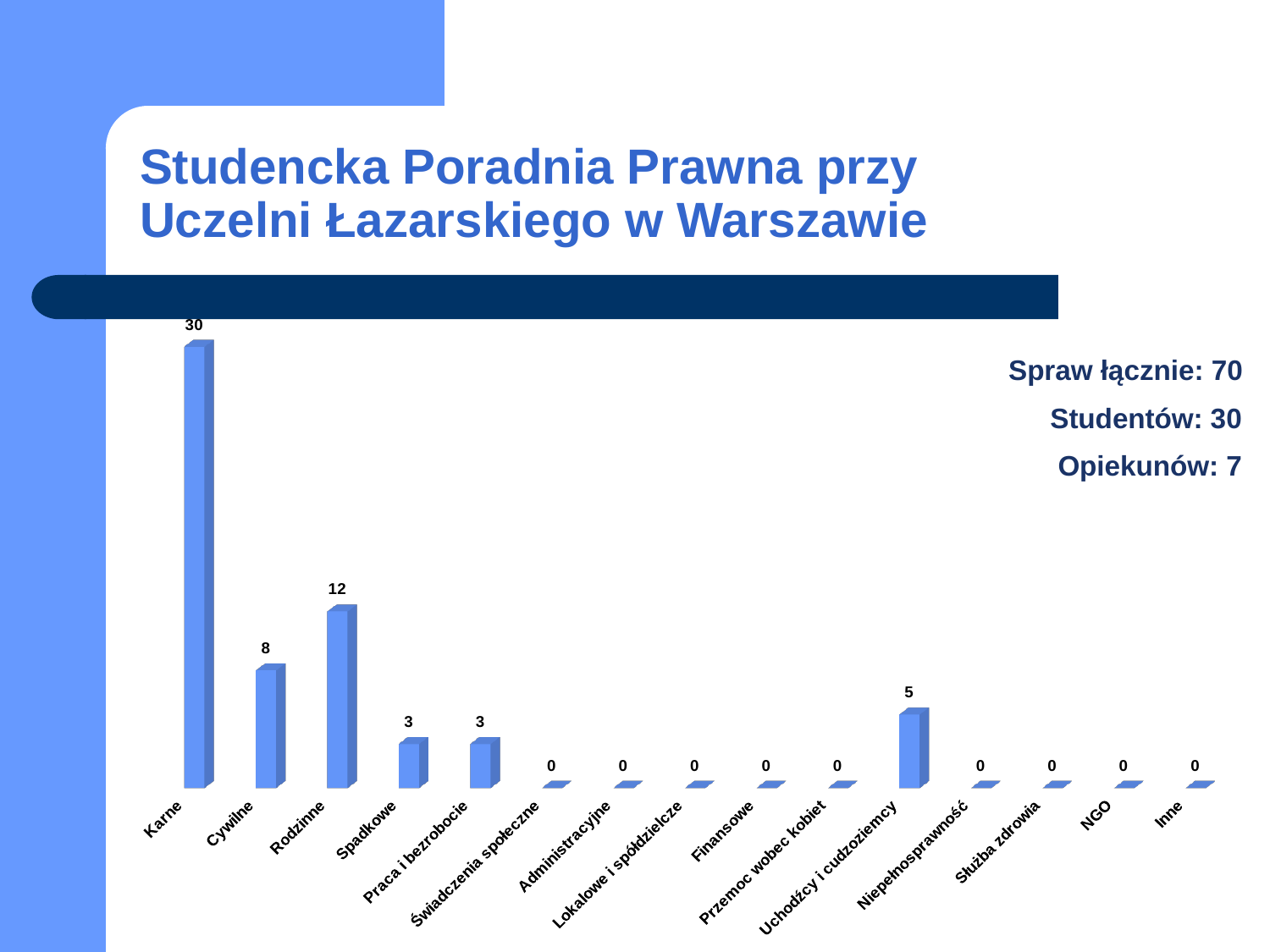
How many categories have a value of 0? 9 Which is larger, the value for Cywilne or the value for Rodzinne? Rodzinne What is the value for Rodzinne? 12 What kind of chart is shown on the slide? Bar chart How many categories are shown on the x axis? 15 What is the value for Karne? 30 What is the difference between the values for Cywilne and Spadkowe? 5 What is the difference between the values for Karne and Rodzinne? 18 What is the value for Uchodźcy i cudzoziemcy? 5 What is the value for Cywilne? 8 What is the value for Praca i bezrobocie? 3 Which category has the highest value? Karne